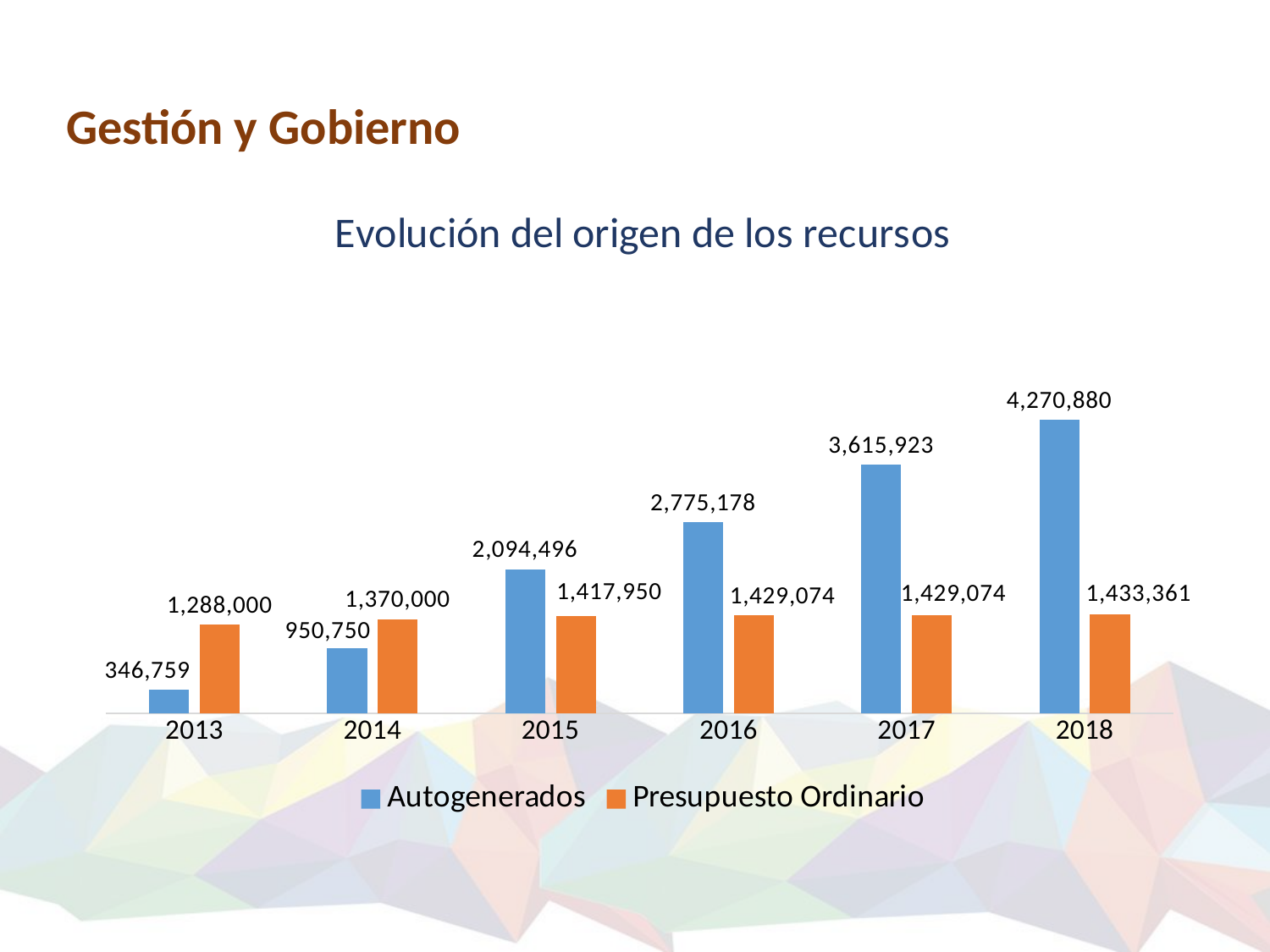
In which year is the Autogenerados value highest? 2018 In which year is the Presupuesto Ordinario value lowest? 2013 What is the difference between Autogenerados and Presupuesto Ordinario in 2018? 2,837,519 By how much did Autogenerados increase from 2013 to 2018? 3,924,121 Do the Autogenerados values rise or fall from 2013 to 2018? Rise How many series does the legend list? 2 How many years are shown on the x axis? 6 What kind of chart is shown? Bar chart What is the value for Autogenerados in 2016? 2,775,178 What is the value for Autogenerados in 2013? 346,759 In 2014, which is larger: Autogenerados or Presupuesto Ordinario? Presupuesto Ordinario What is the value for Presupuesto Ordinario in 2014? 1,370,000